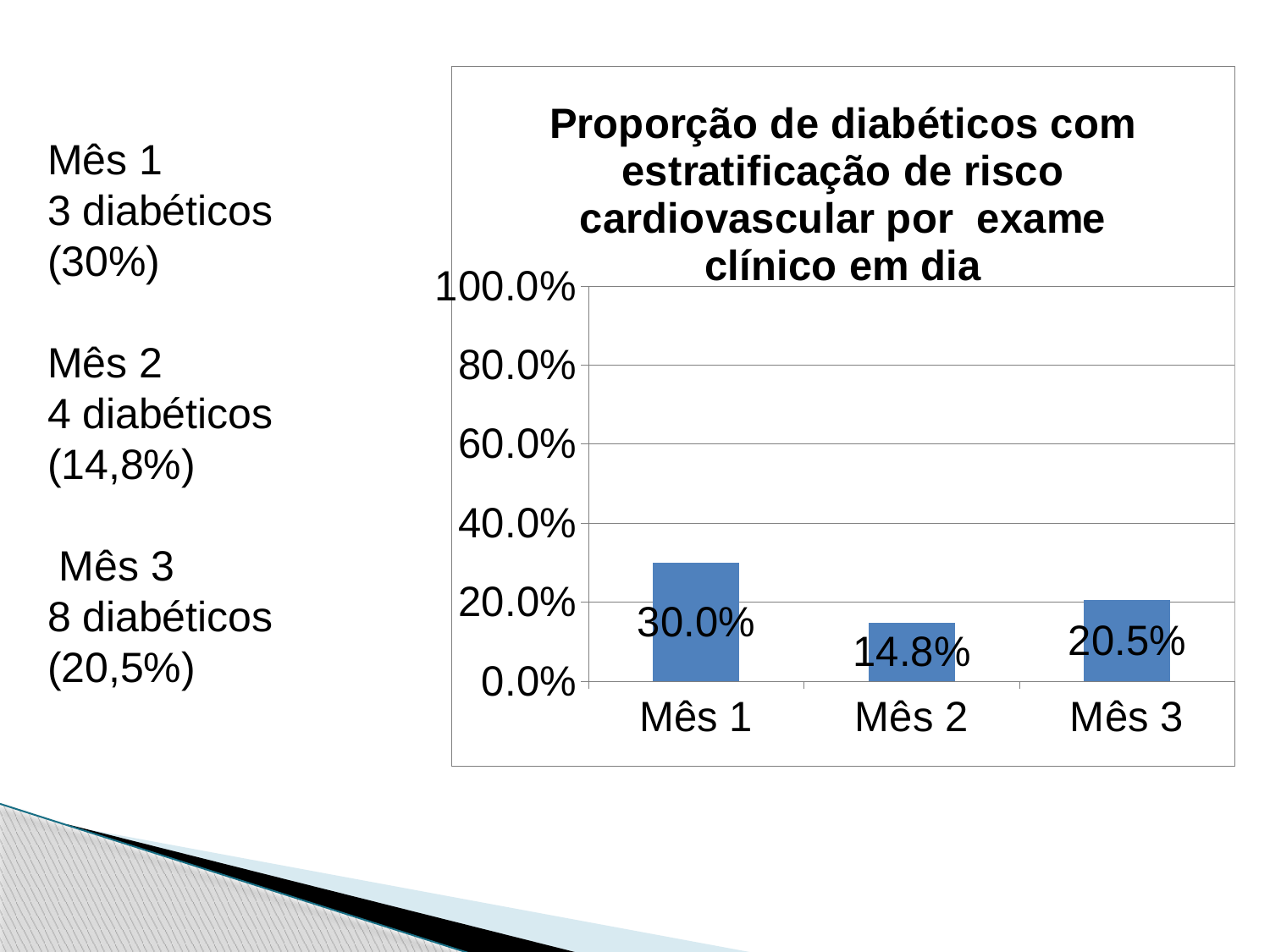
What kind of chart is shown? bar chart Which is larger, the value for Mês 3 or the value for Mês 2? Mês 3 How many months are shown on the x axis? 3 Which month has the lowest value? Mês 2 What is the value for Mês 1? 30.0% Which month has the highest value? Mês 1 What is the difference between the values for Mês 3 and Mês 2? 5.7% Is the value for Mês 1 greater or less than 40.0%? less What is the value for Mês 2? 14.8% What is the title of the chart? Proporção de diabéticos com estratificação de risco cardiovascular por exame clínico em dia What is the value for Mês 3? 20.5% What is the difference between the values for Mês 1 and Mês 2? 15.2%